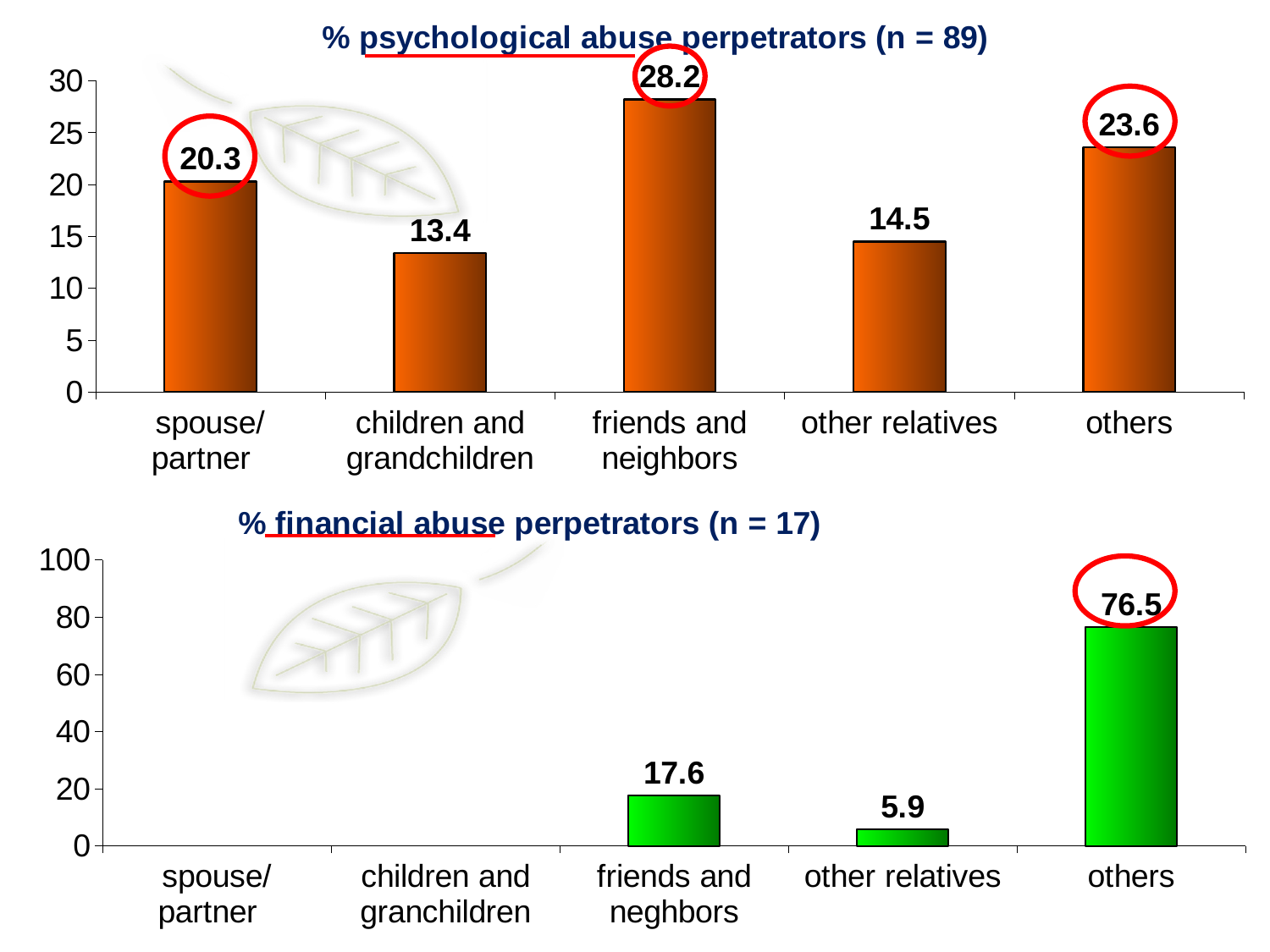
In the '% psychological abuse perpetrators (n = 89)' chart, which category has the lowest value? children and grandchildren In the '% psychological abuse perpetrators (n = 89)' chart, which category has the highest value? friends and neighbors In the '% psychological abuse perpetrators (n = 89)' chart, how many categories are shown on the x axis? 5 In the '% psychological abuse perpetrators (n = 89)' chart, what is the value for spouse/partner? 20.3 What colour are the bars in the '% psychological abuse perpetrators (n = 89)' chart? orange In the '% financial abuse perpetrators (n = 17)' chart, what is the difference between the values for others and friends and neghbors? 58.9 In the '% financial abuse perpetrators (n = 17)' chart, what is the value for other relatives? 5.9 In the '% financial abuse perpetrators (n = 17)' chart, what is the value for others? 76.5 In the '% psychological abuse perpetrators (n = 89)' chart, what is the difference between the values for others and other relatives? 9.1 What kind of chart is the '% financial abuse perpetrators (n = 17)' chart? bar chart In the '% financial abuse perpetrators (n = 17)' chart, which is larger, the value for friends and neghbors or the value for other relatives? friends and neghbors In the '% psychological abuse perpetrators (n = 89)' chart, what is the value for friends and neighbors? 28.2